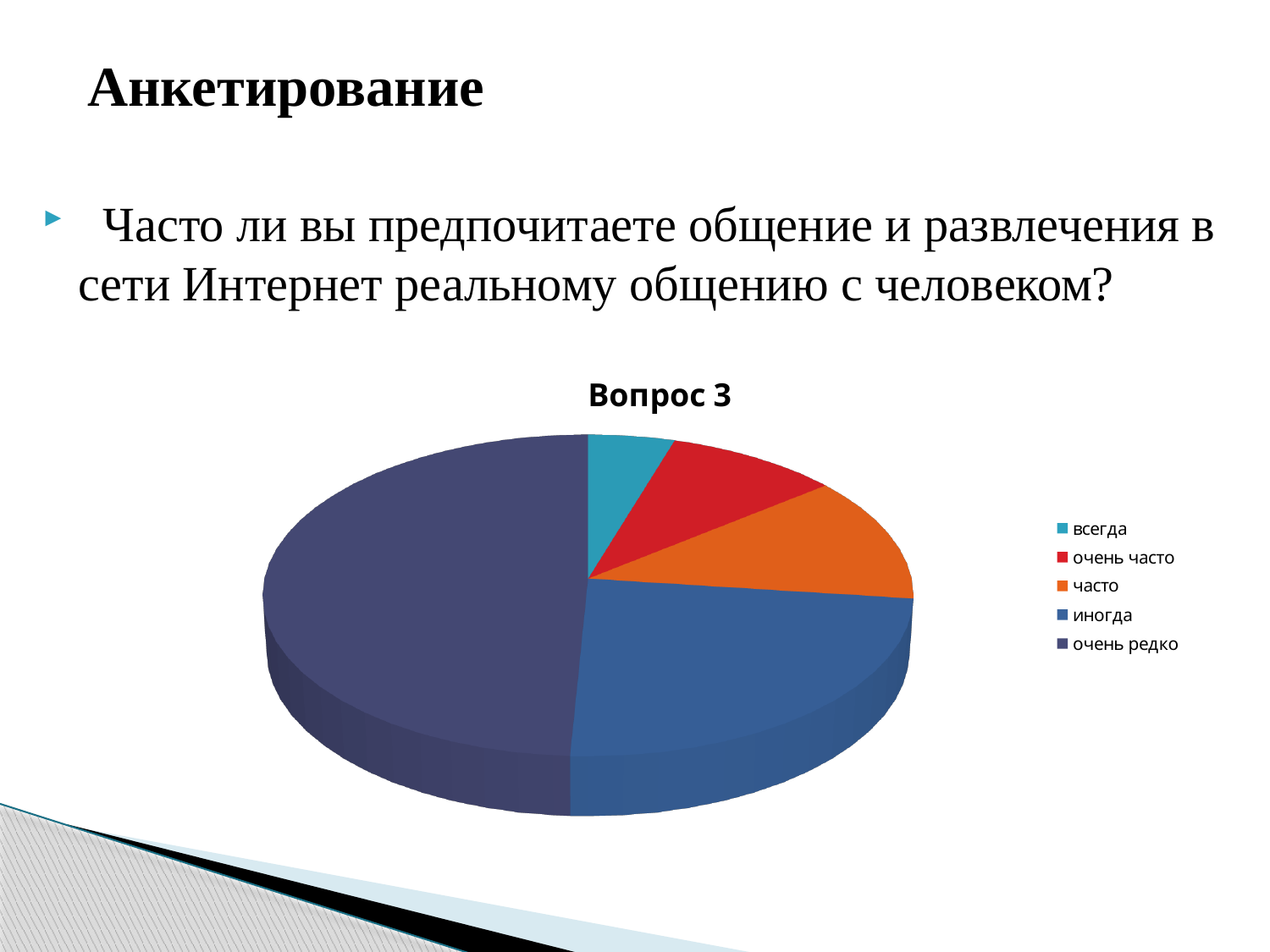
Which slice is larger, "очень редко" or "иногда"? очень редко Which slice is larger, "очень часто" or "всегда"? очень часто Which category has the smallest slice of the pie? всегда How many entries does the legend list? 5 How many slices does the pie chart have? 5 What is the title of the chart? Вопрос 3 Which slice is larger, "часто" or "всегда"? часто What kind of chart is shown on the slide? pie chart Which category has the largest slice of the pie? очень редко What colour is the "часто" slice in the pie chart? orange